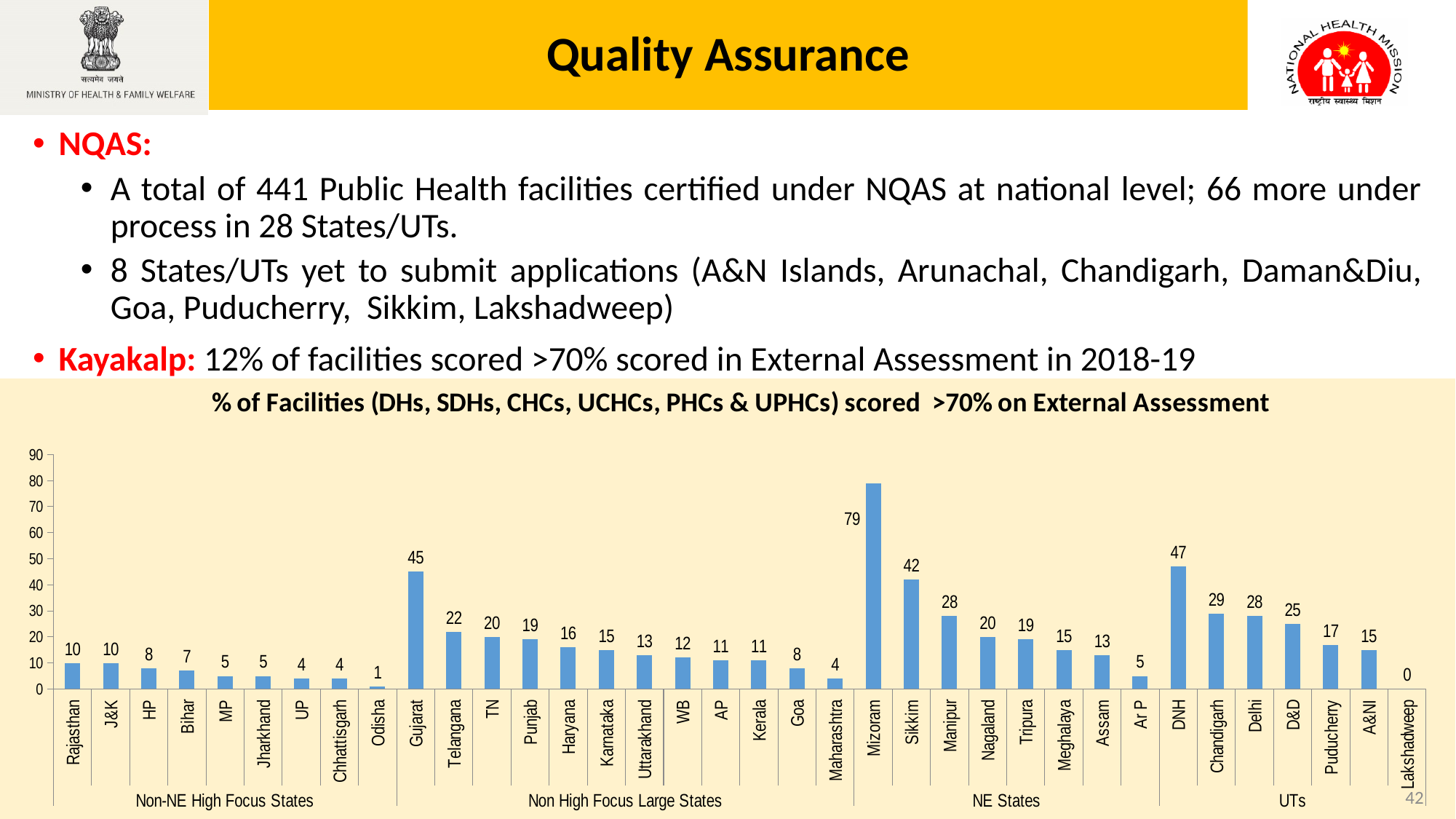
Which has a larger value, Chandigarh or Delhi? Chandigarh Is the value for Mizoram greater or less than 70? greater What kind of chart is shown? Bar chart What is the value for Gujarat? 45 What is the value for Odisha? 1 What is the value for DNH? 47 What is the value for Mizoram? 79 Which state or UT has the lowest value? Lakshadweep What is the title of the chart? % of Facilities (DHs, SDHs, CHCs, UCHCs, PHCs & UPHCs) scored >70% on External Assessment What is the difference between the values for Mizoram and Sikkim? 37 Which state or UT has the highest value? Mizoram How many states/UTs are shown on the chart? 36